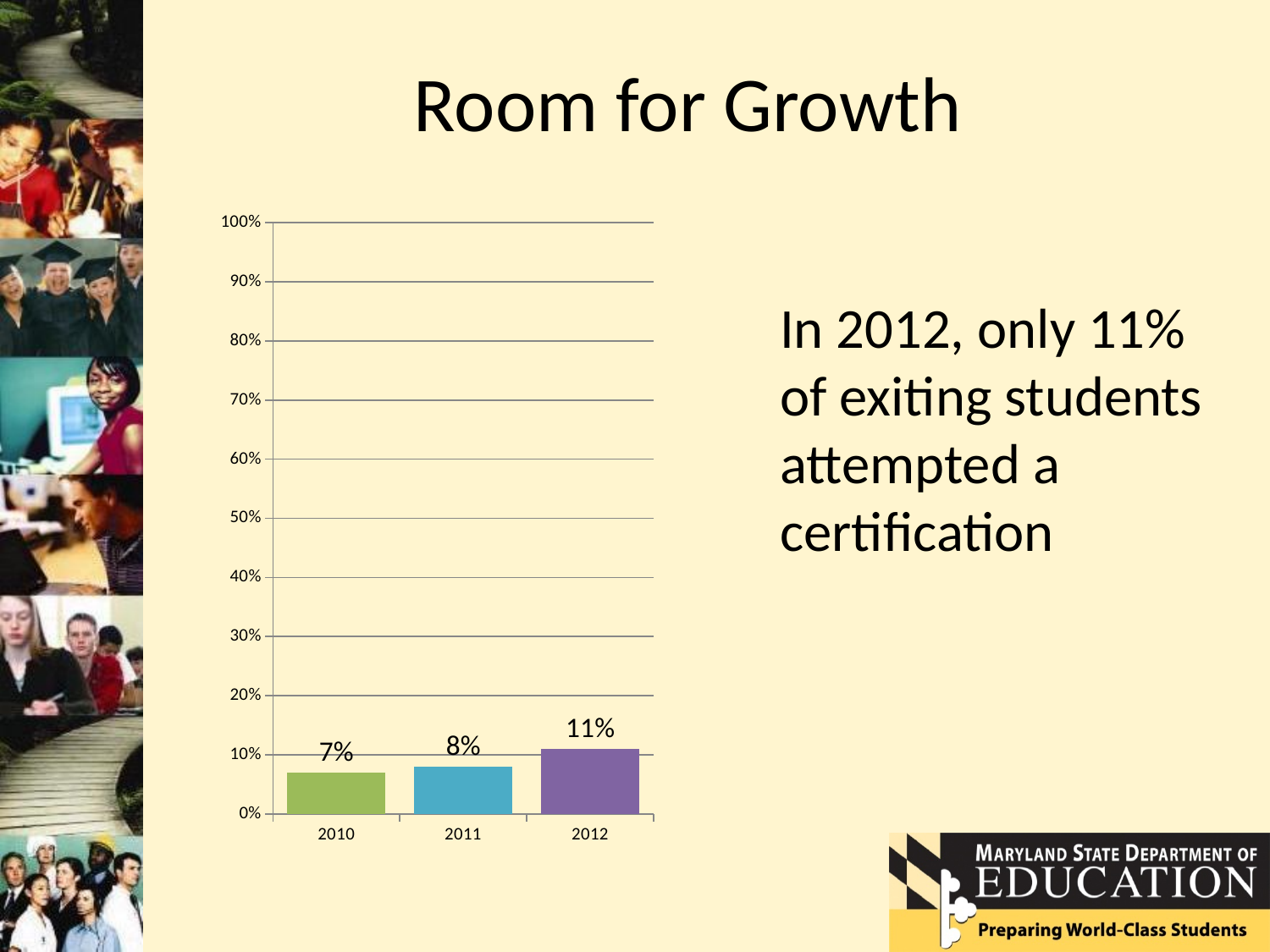
What is the value for 2012? 11% Which is larger, the value for 2012 or the value for 2011? 2012 Is the value for 2012 greater or less than 10%? greater What is the difference between the values for 2011 and 2010? 1% What is the value for 2011? 8% How many years are shown on the x axis? 3 Which year has the lowest value? 2010 What is the value for 2010? 7% Do the values rise or fall from 2010 to 2012? rise What is the difference between the values for 2012 and 2010? 4% What kind of chart is shown on the slide? bar chart Which year has the highest value? 2012